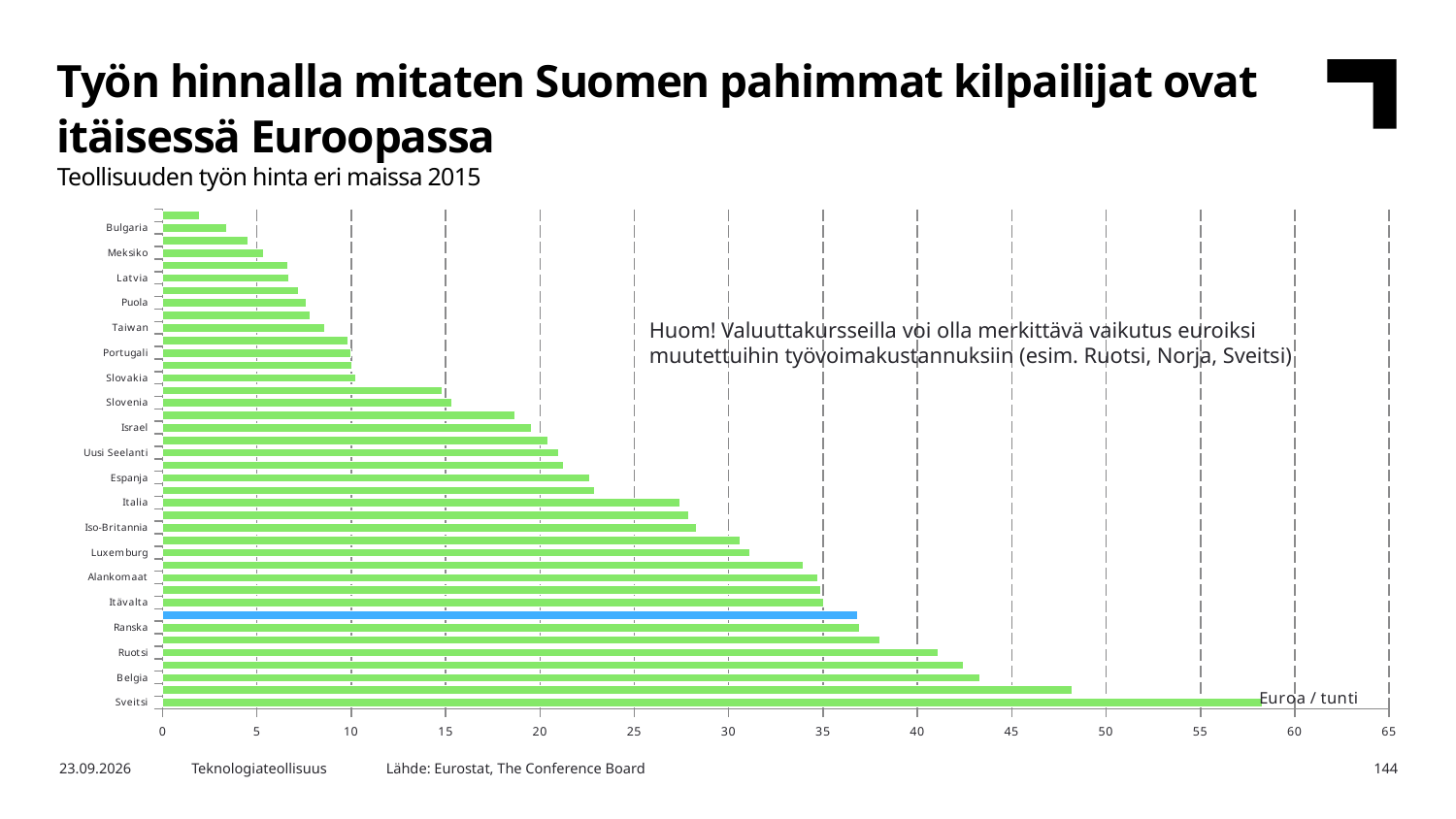
Do the bar values increase or decrease going from the top of the chart to the bottom? increase Is the value for Italia greater or less than 25? greater Which has a higher value, Belgia or Espanja? Belgia What unit is shown at the end of the x axis of the chart? Euroa / tunti Is the value for Sveitsi greater or less than 55? greater Which country has the highest labour cost in the chart? Sveitsi Is the value for Iso-Britannia greater or less than 25? greater What kind of chart is shown on the slide? bar chart